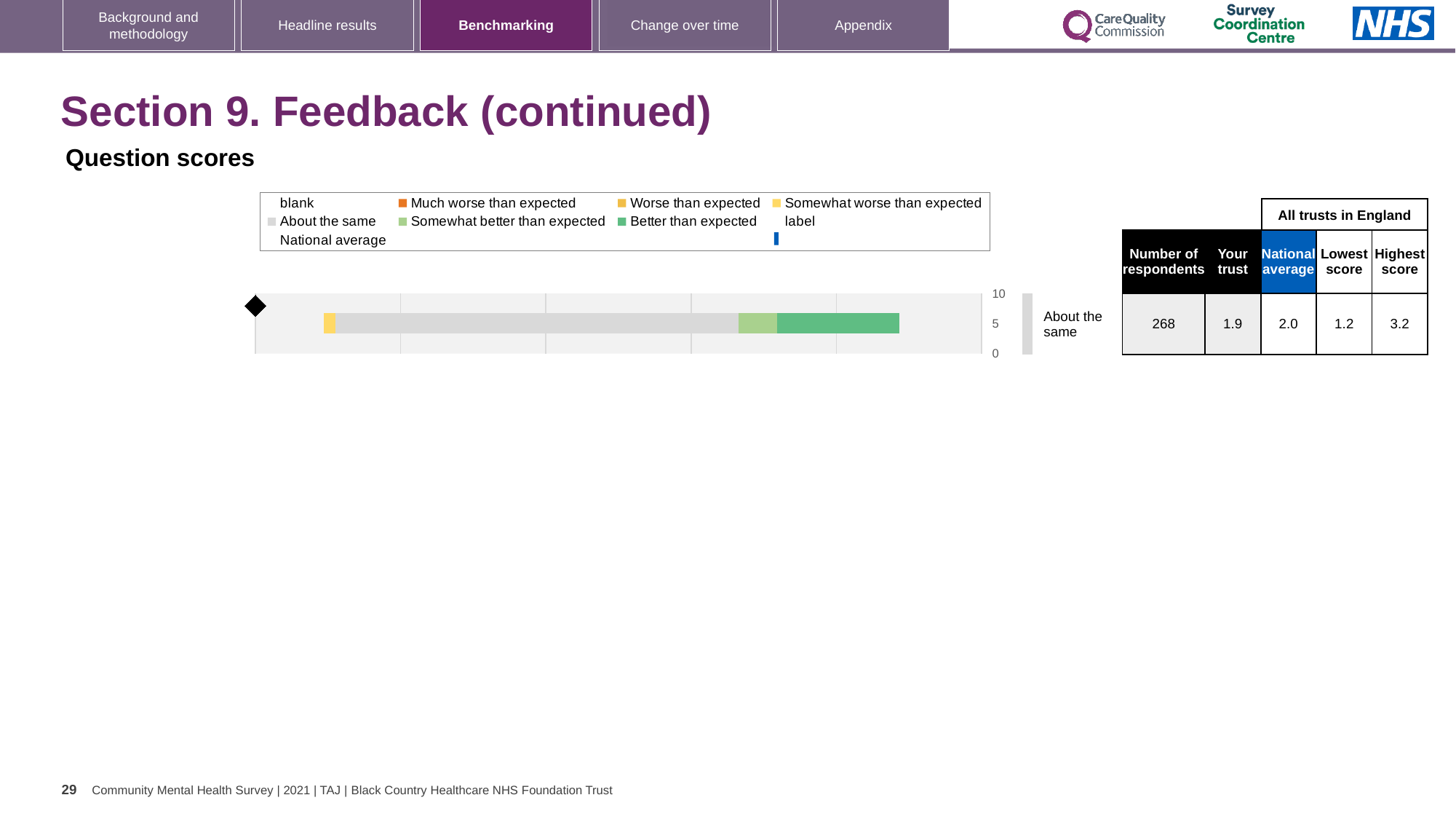
Which is larger for 'About the same': the Your trust score or the National average score? National average In the table beside the chart, what is the Lowest score among all trusts in England? 1.2 What kind of chart is shown on the slide? bar chart In the table beside the chart, what is the Highest score among all trusts in England? 3.2 In the table beside the chart, what is the National average score for 'About the same'? 2.0 What is the difference between the Highest score and the Lowest score for 'About the same'? 2.0 What is the category label shown next to the bar in the chart? About the same What colour does the legend use for 'Better than expected'? green In the table beside the chart, what is the Number of respondents for 'About the same'? 268 What is the highest value shown on the chart's axis? 10 In the table beside the chart, what is the 'Your trust' score for 'About the same'? 1.9 How many bars are plotted in the chart? 1